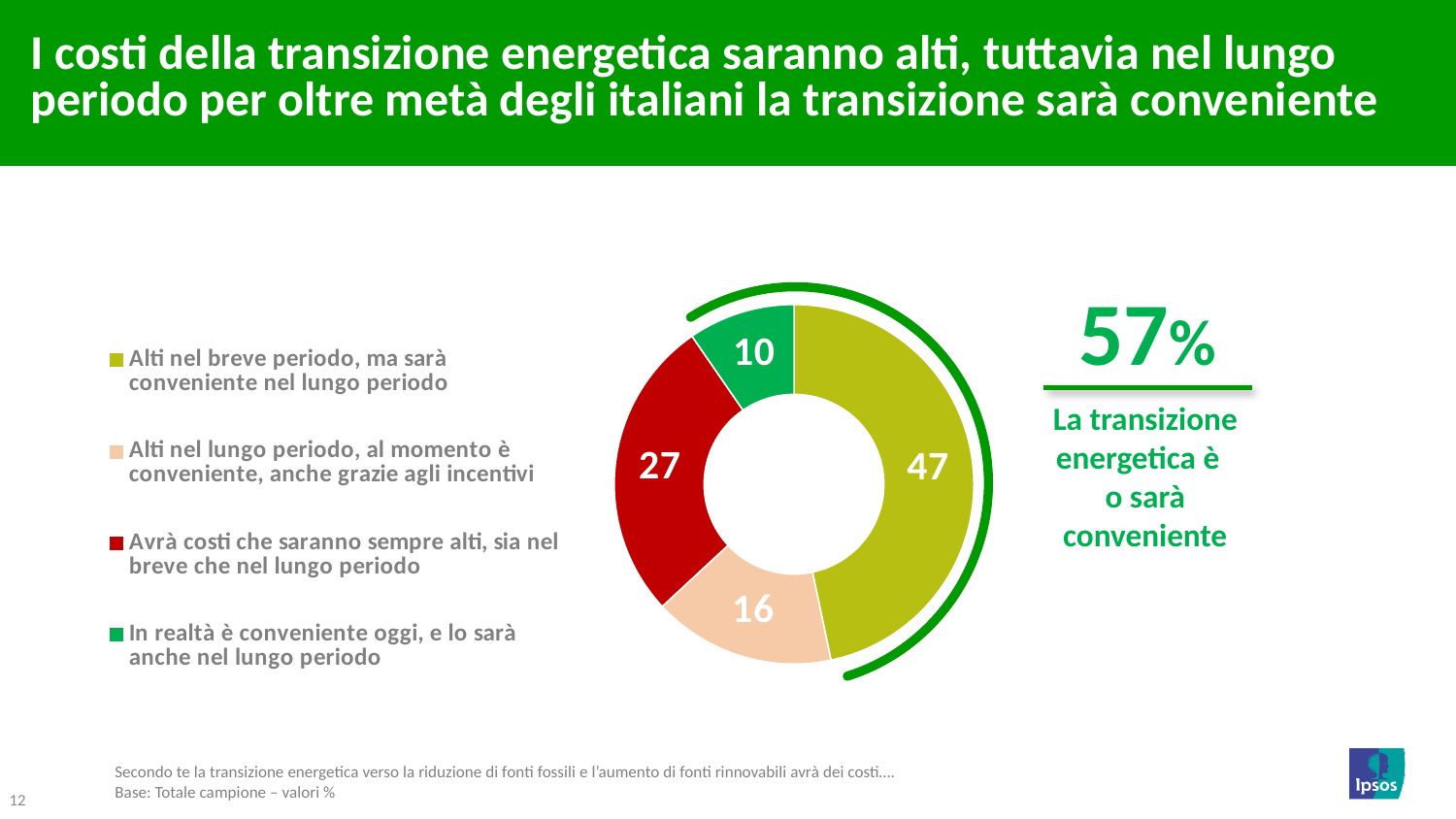
What percentage is highlighted next to the chart as "La transizione energetica è o sarà conveniente"? 57% What is the value for "In realtà è conveniente oggi, e lo sarà anche nel lungo periodo"? 10 Which category has the smallest slice of the donut chart? In realtà è conveniente oggi, e lo sarà anche nel lungo periodo Which category has the largest slice of the donut chart? Alti nel breve periodo, ma sarà conveniente nel lungo periodo Which is larger: the value for "Alti nel lungo periodo, al momento è conveniente, anche grazie agli incentivi" or the value for "In realtà è conveniente oggi, e lo sarà anche nel lungo periodo"? Alti nel lungo periodo, al momento è conveniente, anche grazie agli incentivi How many categories does the donut chart show? 4 What type of chart is shown on the slide? Donut (pie) chart What is the value for "Avrà costi che saranno sempre alti, sia nel breve che nel lungo periodo"? 27 What is the value for "Alti nel lungo periodo, al momento è conveniente, anche grazie agli incentivi"? 16 What is the value for "Alti nel breve periodo, ma sarà conveniente nel lungo periodo"? 47 What is the difference between the value for "Alti nel breve periodo, ma sarà conveniente nel lungo periodo" and the value for "Avrà costi che saranno sempre alti, sia nel breve che nel lungo periodo"? 20 What colour is the slice for "Avrà costi che saranno sempre alti, sia nel breve che nel lungo periodo"? Red